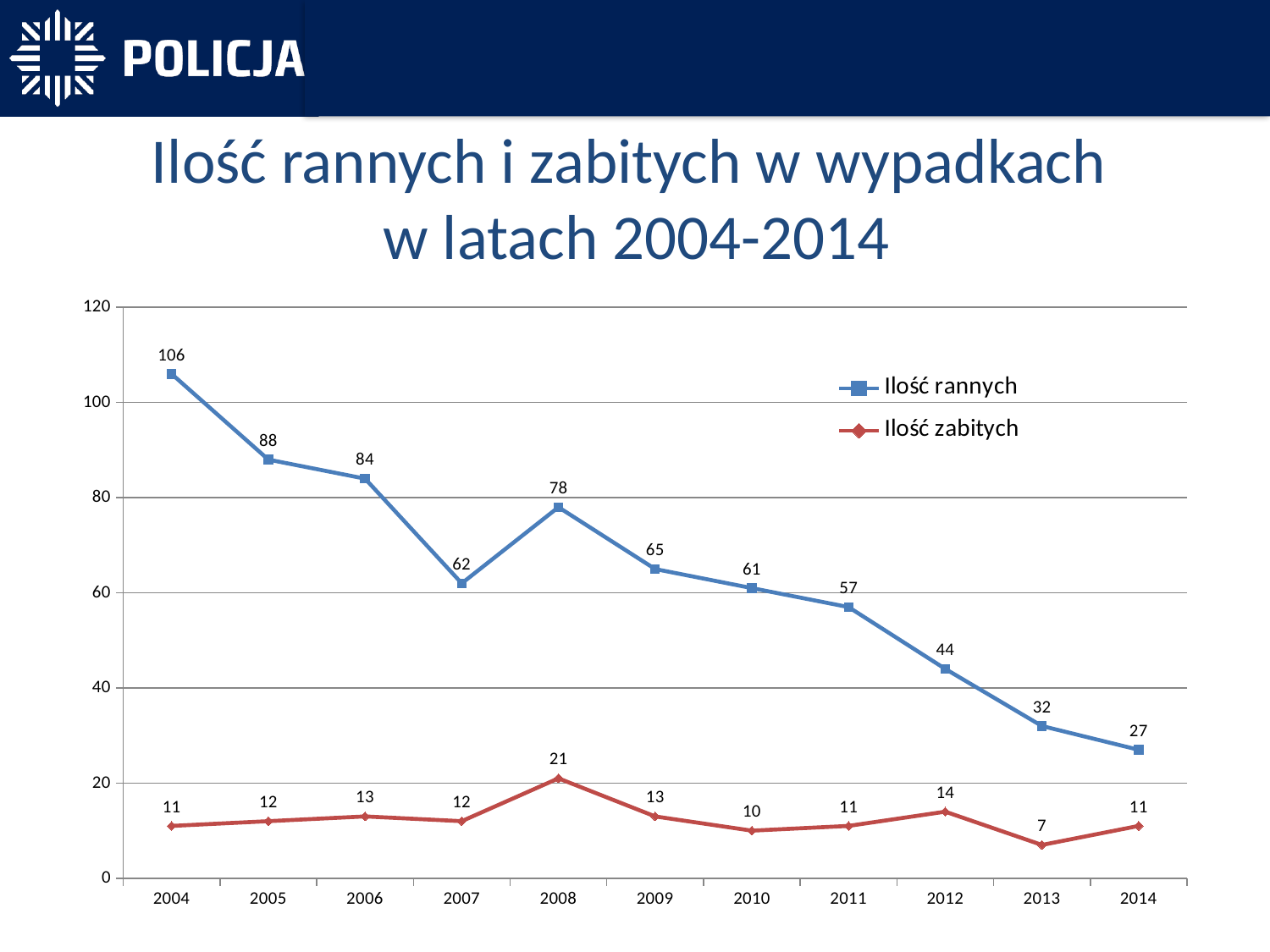
In which year is Ilość zabitych lowest? 2013 What is the value of Ilość rannych in 2004? 106 What is the difference between Ilość rannych in 2004 and in 2014? 79 What kind of chart is shown on the slide? line chart How many series does the legend list? 2 In which year is Ilość rannych highest? 2004 What is the value of Ilość zabitych in 2008? 21 What colour is the line for Ilość zabitych? red Does Ilość rannych generally rise or fall from 2004 to 2014? fall How many years are shown on the x axis? 11 Which is larger: Ilość rannych in 2007 or Ilość rannych in 2008? 2008 What is the value of Ilość rannych in 2014? 27